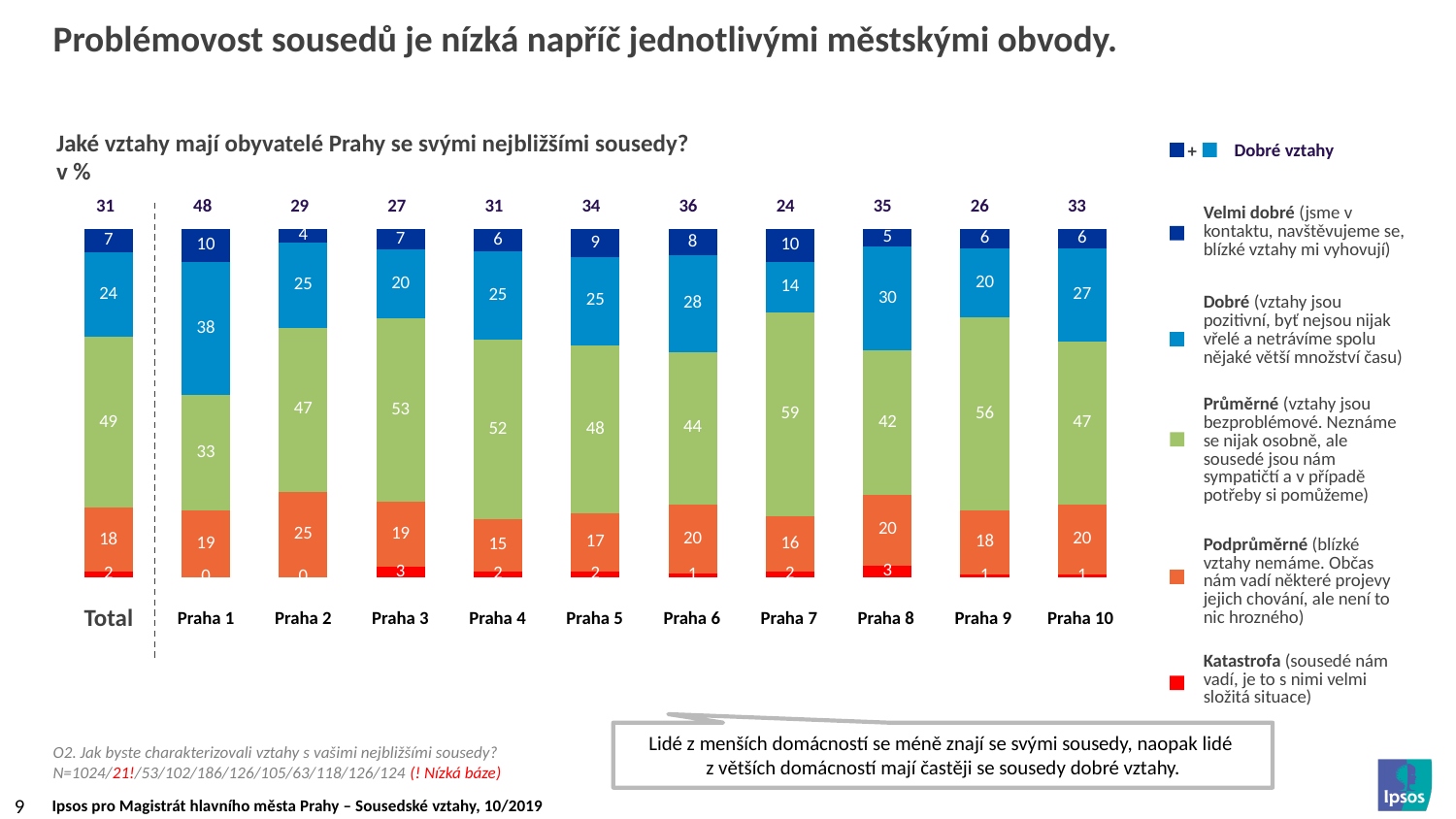
What kind of chart is shown on the slide? Stacked bar chart Which city district has the highest Průměrné value? Praha 7 How many series does the legend list? 5 What is the combined 'Dobré vztahy' value (Velmi dobré plus Dobré) printed above the Praha 1 bar? 48 Which city district has the lowest Velmi dobré value? Praha 2 How many categories (bars) are shown on the x axis? 11 Which category has the highest combined 'Dobré vztahy' value shown above the bars? Praha 1 What is the Velmi dobré value for Praha 1? 10 What is the Podprůměrné value for the Total bar? 18 Which has a larger Katastrofa value, Praha 3 or Praha 6? Praha 3 What percentage of respondents in Praha 7 rated their relations with neighbours as Průměrné? 59 What is the difference between the Dobré values for Praha 1 and Praha 7? 24